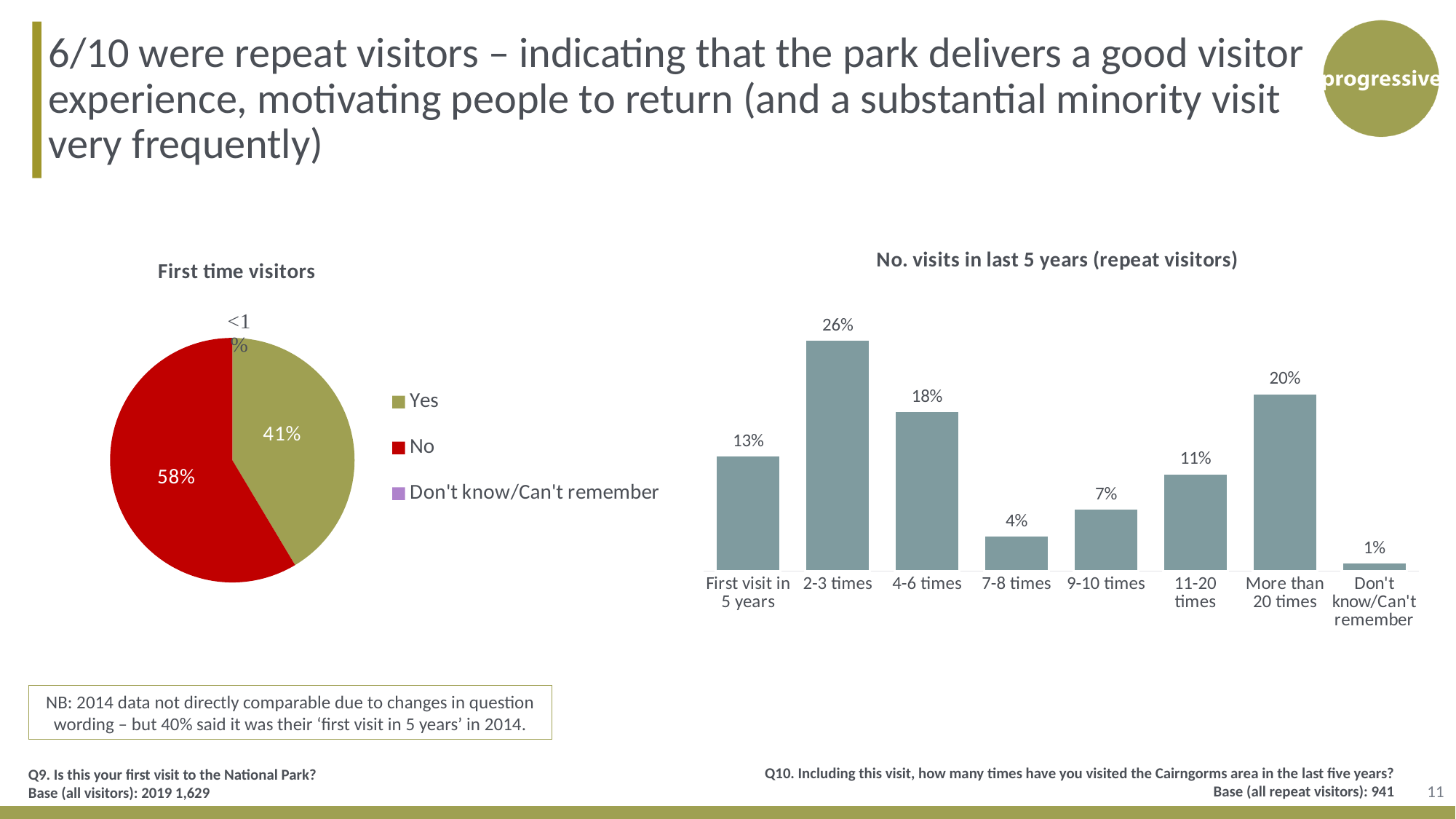
In the 'First time visitors' pie chart, what share of visitors answered 'Yes'? 41% In the 'No. visits in last 5 years (repeat visitors)' chart, what is the value for 'More than 20 times'? 20% In the 'First time visitors' pie chart, what share of visitors answered 'No'? 58% How many entries does the legend of the 'First time visitors' pie chart list? 3 What kind of chart is 'No. visits in last 5 years (repeat visitors)'? Bar chart How many categories are shown in the 'No. visits in last 5 years (repeat visitors)' chart? 8 In the 'No. visits in last 5 years (repeat visitors)' chart, what is the value for '2-3 times'? 26% In the 'No. visits in last 5 years (repeat visitors)' chart, which category has the highest value? 2-3 times In the 'No. visits in last 5 years (repeat visitors)' chart, which category has the lowest value? Don't know/Can't remember In the 'First time visitors' pie chart, which category has the largest slice? No In the 'No. visits in last 5 years (repeat visitors)' chart, what is the difference between '4-6 times' and '7-8 times'? 14% In the 'No. visits in last 5 years (repeat visitors)' chart, which is larger: '11-20 times' or '9-10 times'? 11-20 times